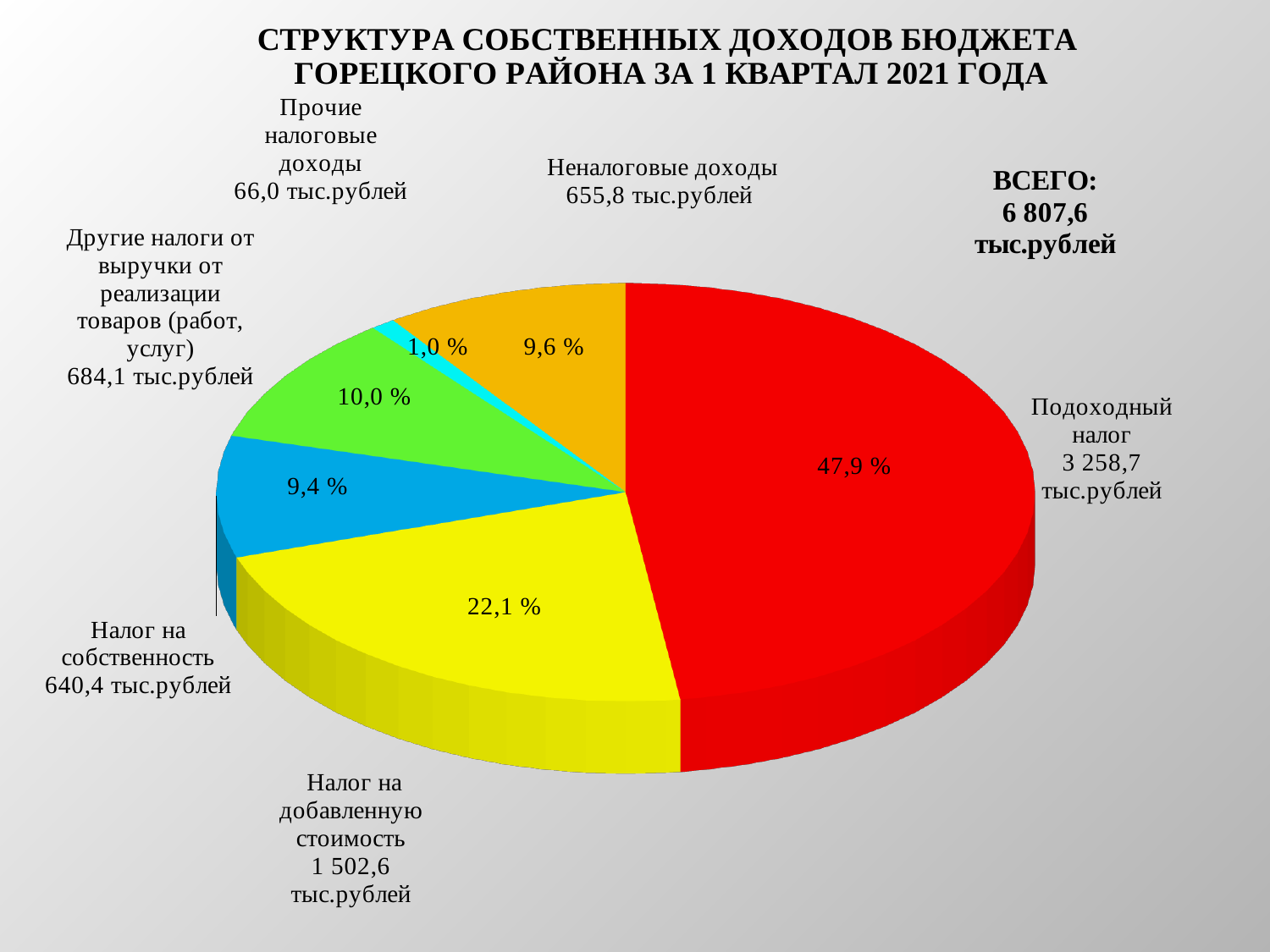
What is the value for Неналоговые доходы? 655,8 тыс.рублей What is the value for Налог на добавленную стоимость? 1 502,6 тыс.рублей Which category has the largest slice of the pie? Подоходный налог What is the value for Подоходный налог? 3 258,7 тыс.рублей Which category has the smallest slice of the pie? Прочие налоговые доходы What total (ВСЕГО) is shown on the slide? 6 807,6 тыс.рублей What share of the pie does Налог на добавленную стоимость take? 22,1 % What kind of chart is shown on the slide? pie chart What share of the pie does Подоходный налог take? 47,9 % How many slices does the pie chart have? 6 What is the difference between Подоходный налог and Налог на добавленную стоимость in тыс.рублей? 1 756,1 тыс.рублей Which is larger: Налог на собственность or Неналоговые доходы? Неналоговые доходы